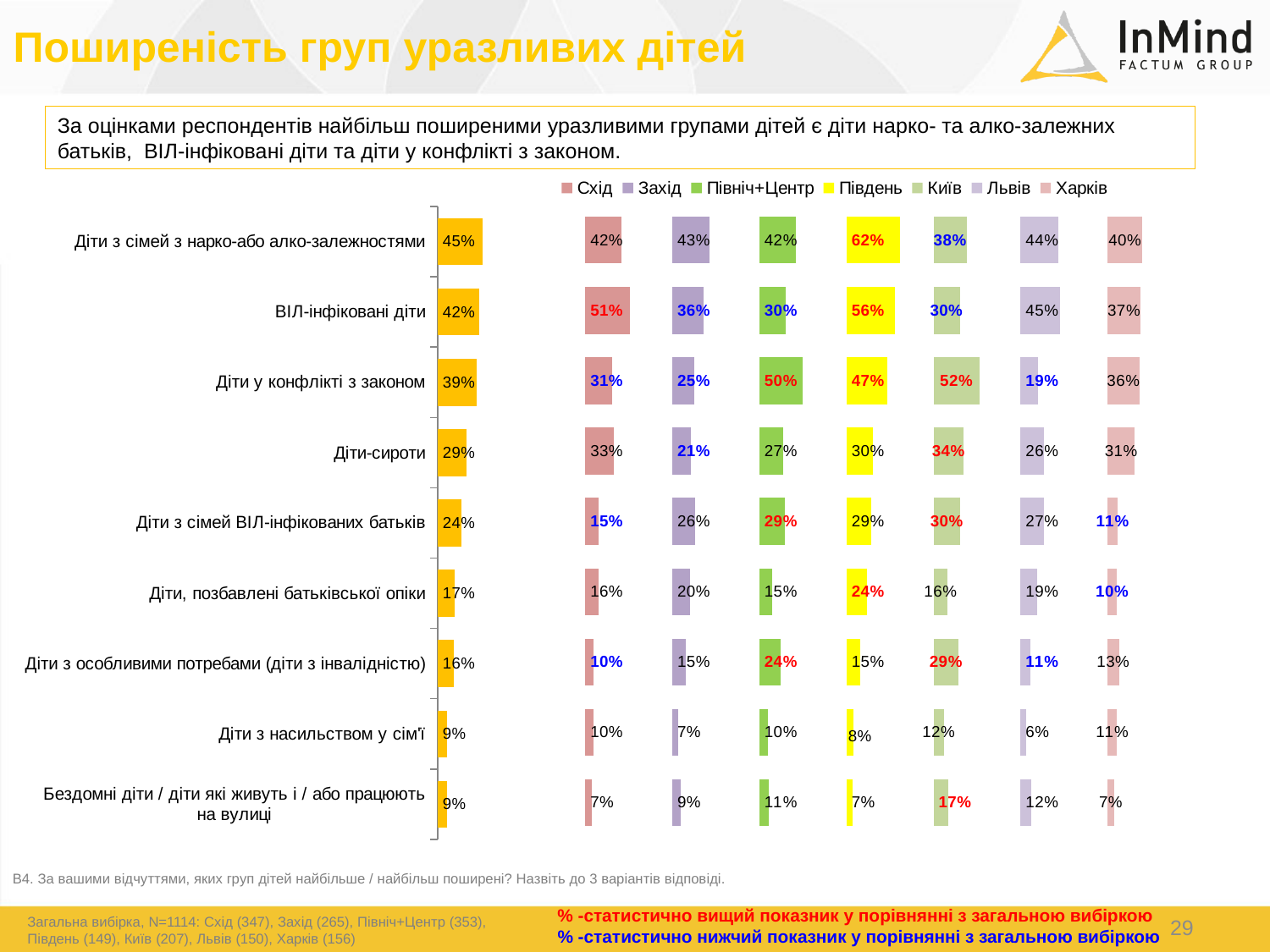
Which region has the highest value for the category "Діти з сімей з нарко-або алко-залежностями"? Південь What is the value for Схід for the category "ВІЛ-інфіковані діти"? 51% How many series does the legend list? 7 Which series in the legend is shown in yellow? Південь What is the difference between the Південь and Київ values for the category "ВІЛ-інфіковані діти"? 26% What kind of chart is shown on the slide? Bar chart Which region has the lowest value for the category "Діти у конфлікті з законом"? Львів What is the value for Південь for the category "Діти з сімей з нарко-або алко-залежностями"? 62% For the category "Діти з особливими потребами (діти з інвалідністю)", which is larger: the value for Київ or the value for Схід? Київ How many categories of vulnerable children are shown on the chart? 9 What is the value for Київ for the category "Бездомні діти / діти які живуть і / або працюють на вулиці"? 17% What is the value for Львів for the category "Діти у конфлікті з законом"? 19%